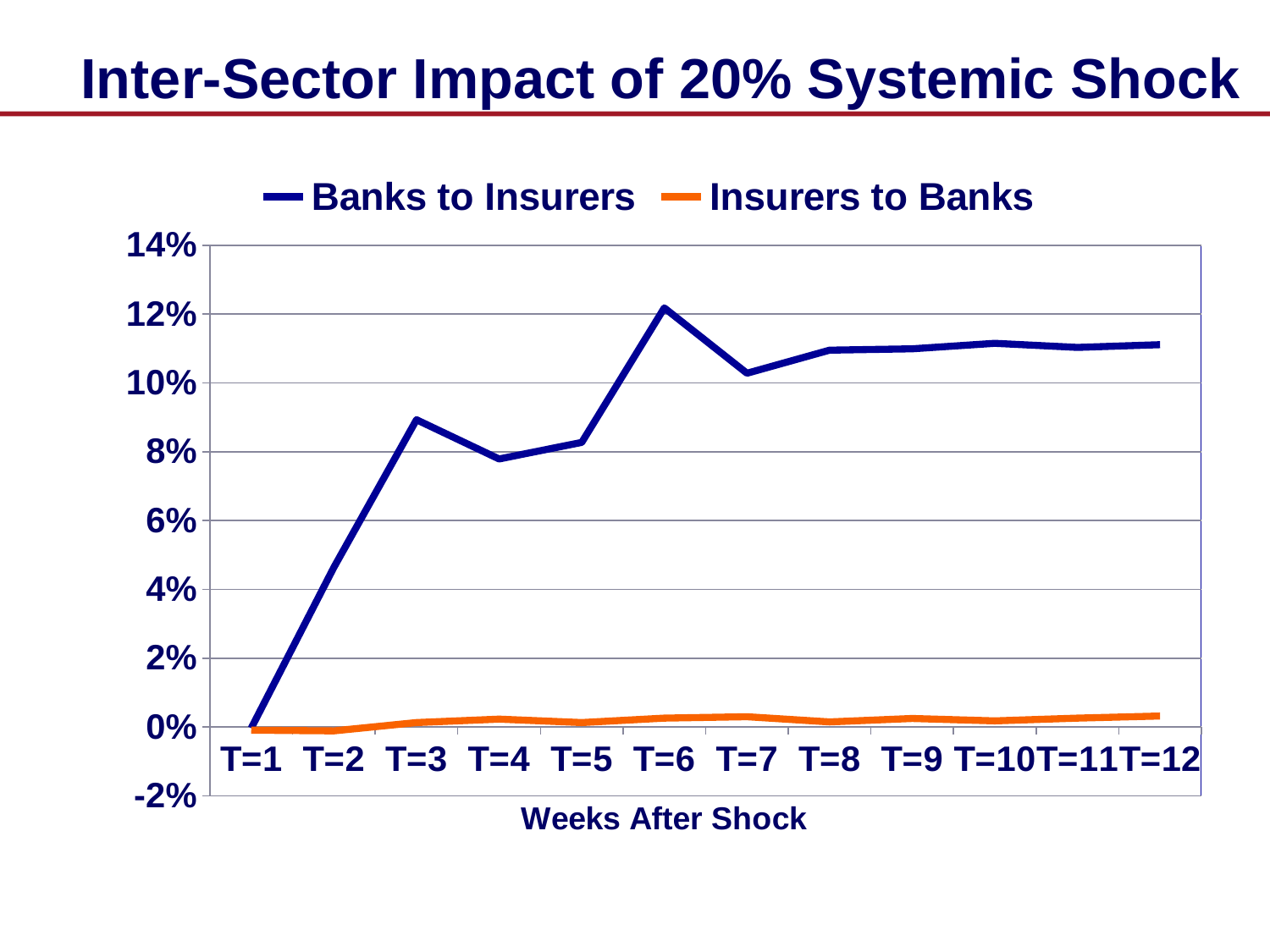
Is the value for Banks to Insurers at T=2 greater or less than 6%? less How many time points are plotted along the x axis? 12 What is the label of the x axis? Weeks After Shock At which week is the Banks to Insurers series at its lowest value? T=1 How many series does the legend list? 2 Which series is higher at T=6, Banks to Insurers or Insurers to Banks? Banks to Insurers Is the value for Banks to Insurers at T=3 greater or less than 8%? greater What kind of chart is shown on the slide? line chart Is the value for Insurers to Banks at T=12 greater or less than 2%? less At which week does the Banks to Insurers series reach its highest value? T=6 Does the Banks to Insurers series rise or fall from T=1 to T=3? rise